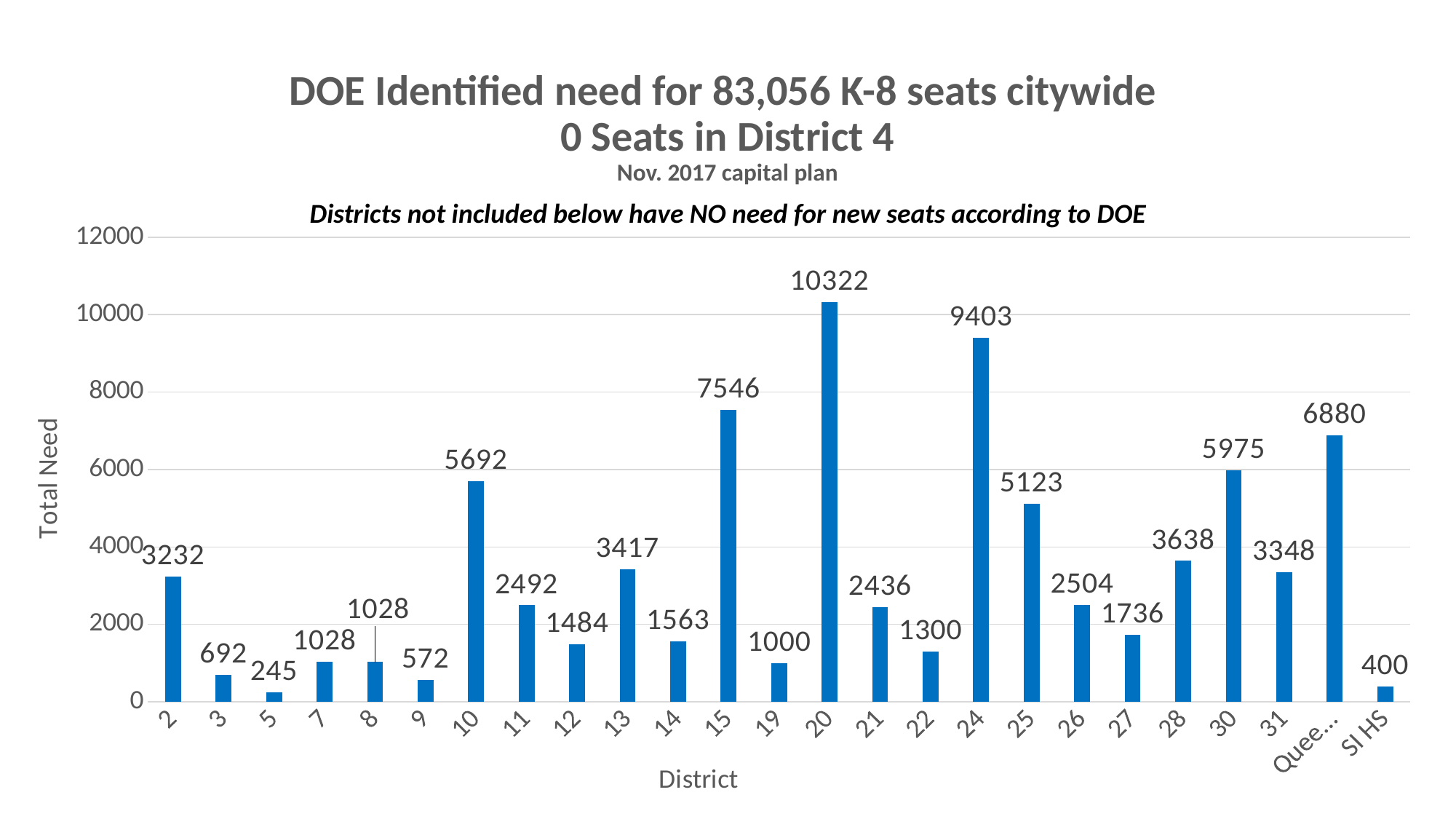
What is the difference in total need between District 15 and District 10? 1854 What is the total need shown for District 15? 7546 What is the difference in total need between District 20 and District 24? 919 What is the total need shown for SI HS? 400 What is the total need shown for District 31? 3348 Which district has the highest total need? 20 What is the total need shown for District 20? 10322 What is the label of the vertical axis? Total Need Which district has the lowest total need? 5 How many districts (categories) are plotted on the chart? 25 Which has a larger total need, District 25 or District 30? District 30 What type of chart is shown on the slide? Bar chart